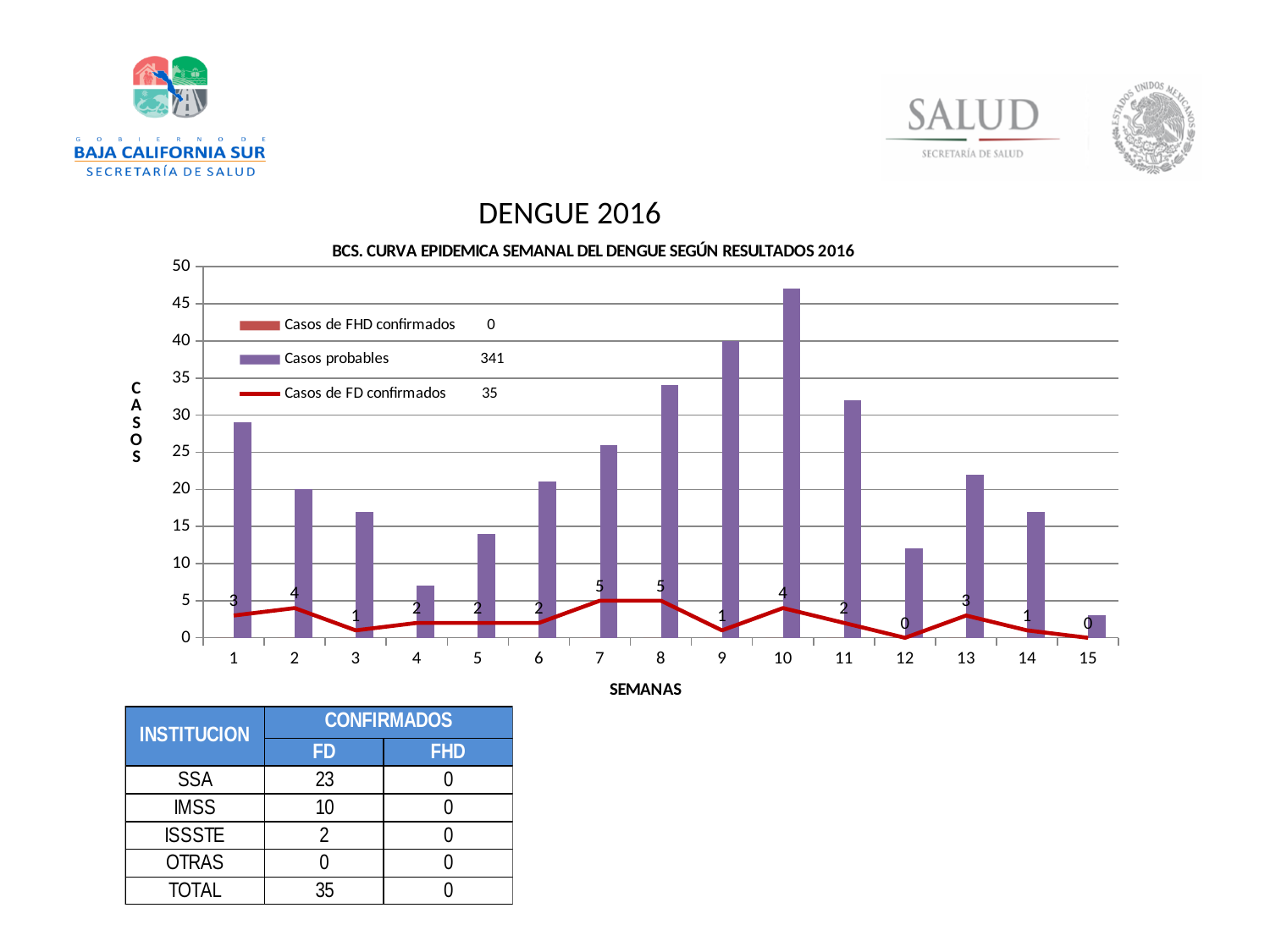
Which week has the highest bar for Casos probables? 10 Is the Casos probables bar for week 10 greater or less than 40? greater How many weeks are shown on the x axis? 15 Is the Casos probables bar for week 4 greater or less than 10? less What is the value of Casos de FD confirmados in week 7? 5 Do the Casos probables bars rise or fall from week 10 to week 12? fall Which week has the lowest bar for Casos probables? 15 What is the value of Casos de FD confirmados in week 12? 0 What is the value of Casos de FD confirmados in week 2? 4 What is the difference between Casos de FD confirmados in week 2 and week 3? 3 How many series does the legend list? 3 Which week has more Casos de FD confirmados, week 10 or week 11? 10